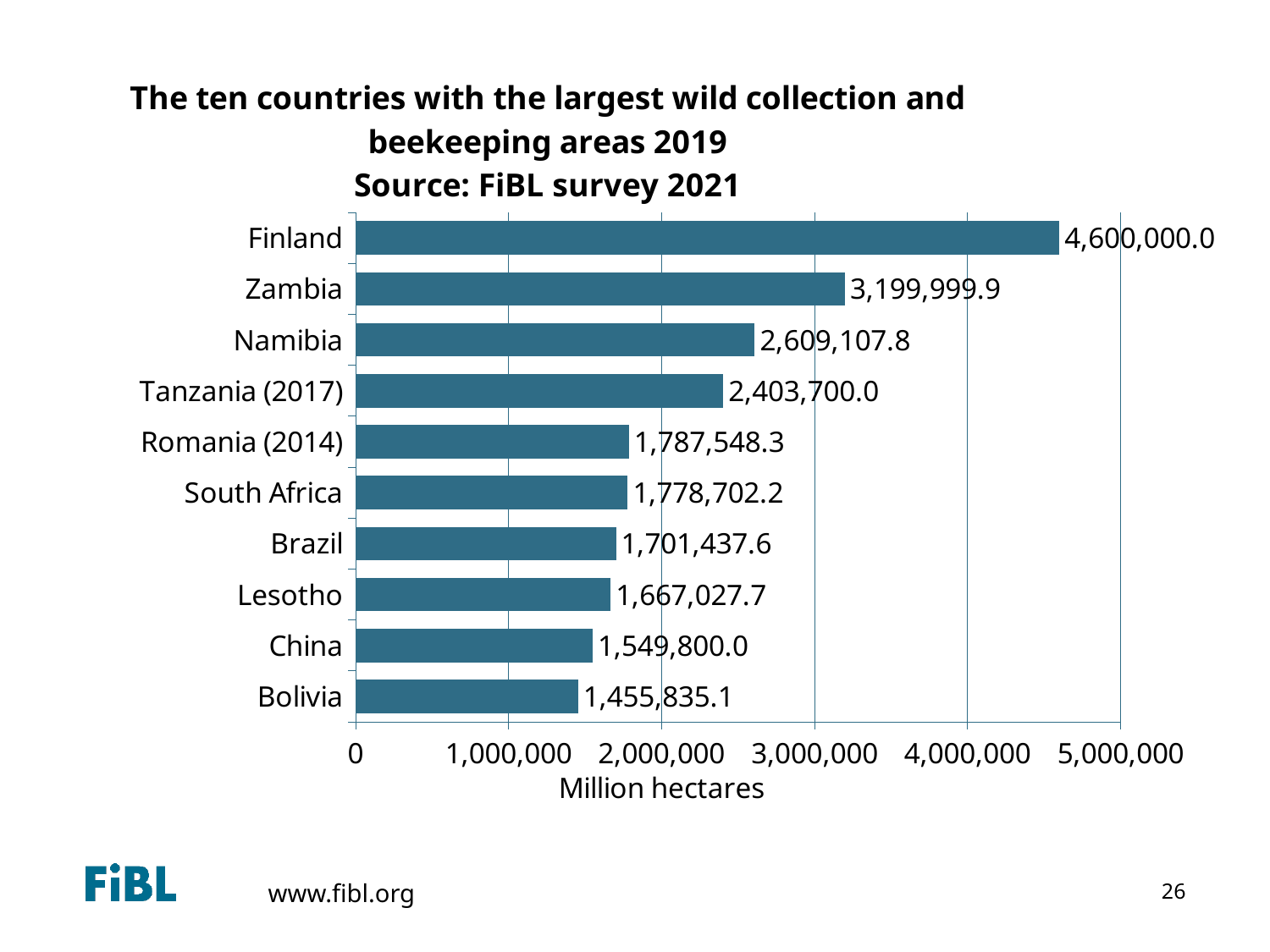
What value is shown for Namibia? 2,609,107.8 What kind of chart is shown on the slide? Bar chart Is the value for Zambia greater or less than 3,000,000? greater Which country has the smallest value in the chart? Bolivia Which country has the largest wild collection and beekeeping area in the chart? Finland How many countries are shown in the chart? 10 What is the wild collection and beekeeping area shown for Finland? 4,600,000.0 Which has a larger value, Namibia or Tanzania (2017)? Namibia What is the label on the horizontal axis of the chart? Million hectares What is the difference between the values for Finland and Zambia? 1,400,000.1 What value is shown for China? 1,549,800.0 What is the difference between the values for China and Bolivia? 93,964.9